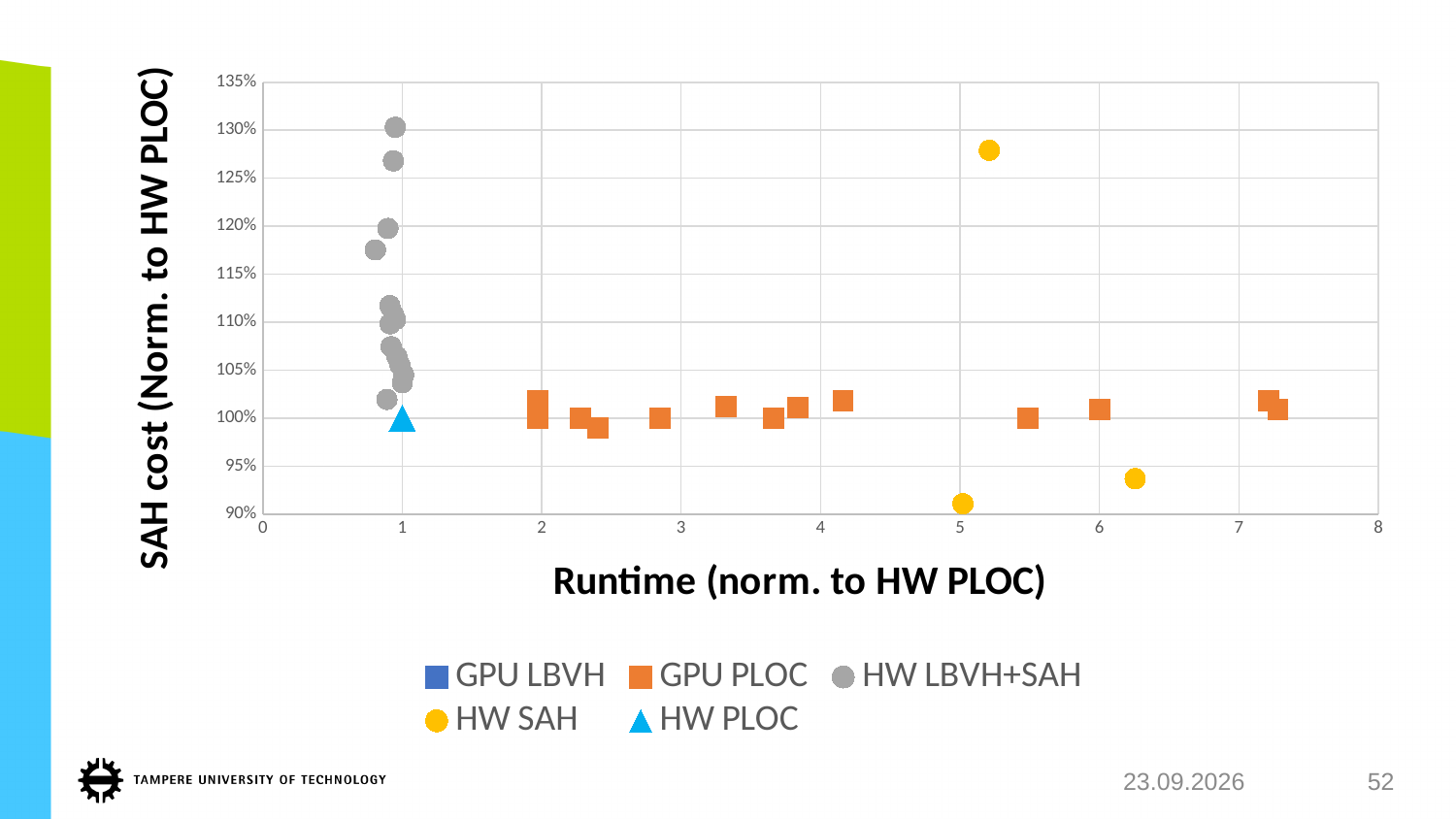
Is the SAH cost of the highest HW SAH point greater or less than 125%? greater Is the runtime of the HW PLOC point greater or less than 2? less What is the title of the x axis? Runtime (norm. to HW PLOC) Which series contains the point with the largest runtime? GPU PLOC What kind of chart is shown on the slide? scatter chart How many series does the legend list? 5 Which series contains the point with the lowest SAH cost? HW SAH How many HW PLOC points are plotted on the chart? 1 What is the title of the y axis? SAH cost (Norm. to HW PLOC) How many HW SAH points are plotted on the chart? 3 Is the SAH cost of the highest HW LBVH+SAH point greater or less than 125%? greater